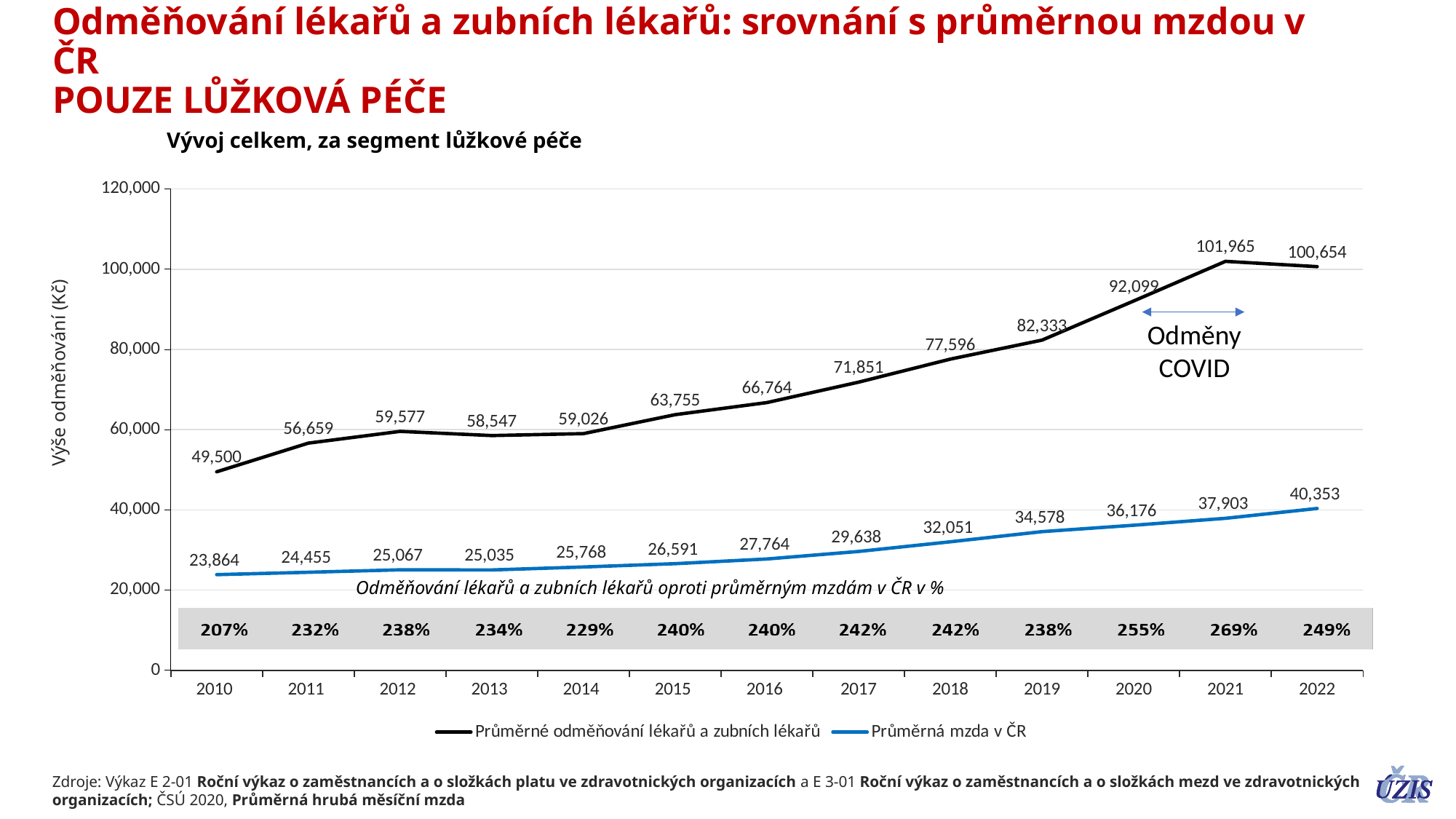
In which year does Průměrné odměňování lékařů a zubních lékařů reach its highest value? 2021 What kind of chart is shown on the slide? line chart What is the difference between Průměrné odměňování lékařů a zubních lékařů and Průměrná mzda v ČR in 2022? 60,301 What is the value of Průměrné odměňování lékařů a zubních lékařů in 2021? 101,965 Is the value of Průměrné odměňování lékařů a zubních lékařů in 2019 greater or less than 80,000? greater What is the value of Průměrná mzda v ČR in 2010? 23,864 In which year is Průměrná mzda v ČR lowest? 2010 Which is larger: Průměrné odměňování lékařů a zubních lékařů in 2013 or in 2014? 2014 By how much did Průměrné odměňování lékařů a zubních lékařů increase from 2020 to 2021? 9,866 How many years are shown on the x axis? 13 How many series does the legend list? 2 What percentage of the average wage in ČR did physicians' remuneration reach in 2021, according to the grey row? 269%